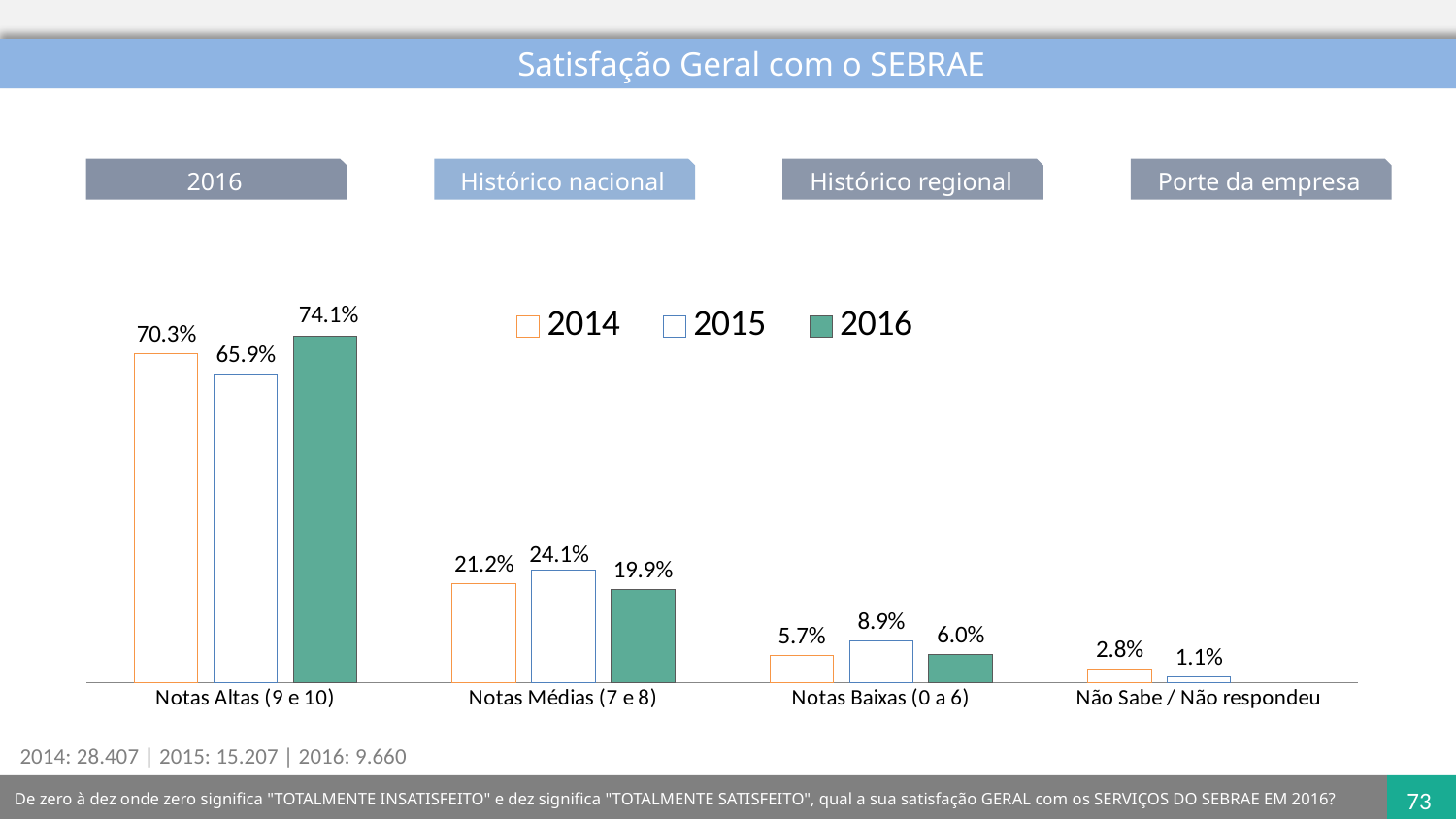
How many series does the legend list? 3 What is the title of the slide containing the chart? Satisfação Geral com o SEBRAE What is the value for 2014 in the Notas Baixas (0 a 6) category? 5.7% How many categories are shown on the x axis of the chart? 4 What is the value for 2016 in the Notas Altas (9 e 10) category? 74.1% What kind of chart is shown on the slide? bar chart What is the value for 2015 in the Notas Médias (7 e 8) category? 24.1% Which is larger in the Notas Baixas (0 a 6) category: the 2015 value or the 2016 value? 2015 What is the value for 2015 in the Não Sabe / Não respondeu category? 1.1% What is the difference between the 2016 and 2015 values in the Notas Altas (9 e 10) category? 8.2% Which year has the highest value in the Notas Altas (9 e 10) category? 2016 Which year has the lowest value in the Notas Médias (7 e 8) category? 2016